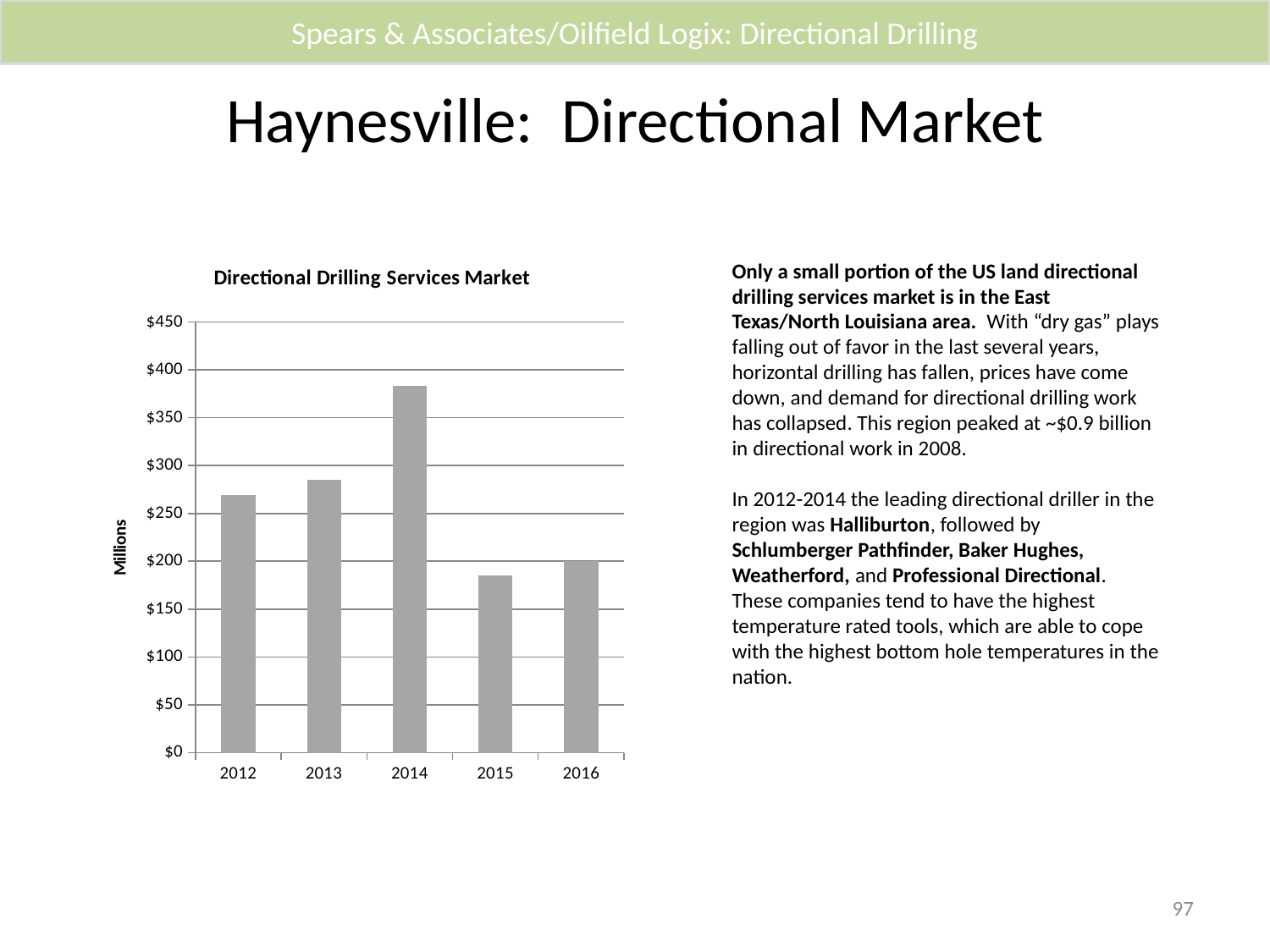
What is the title of the chart? Directional Drilling Services Market Which year has the lowest value in the chart? 2015 Which year has the highest value in the chart? 2014 Is the value for 2012 greater or less than $250? greater What kind of chart is shown on the slide? bar chart Is the value for 2014 greater or less than $350? greater Which is larger, the value for 2014 or the value for 2016? 2014 What is the label on the vertical axis of the chart? Millions How many years are shown on the x axis of the chart? 5 Do the values rise or fall from 2014 to 2015? fall Is the value for 2016 greater or less than $250? less